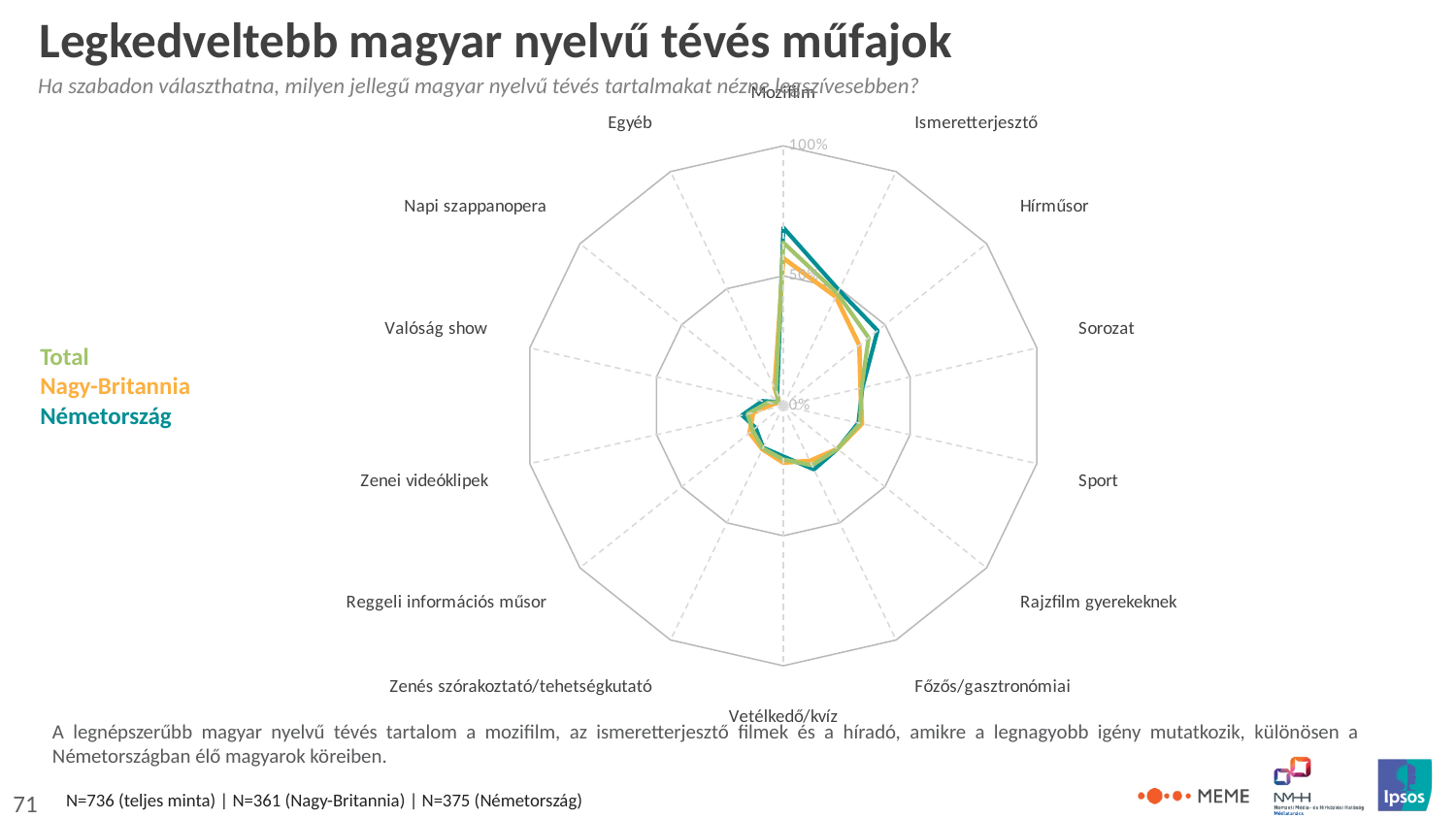
Which series are shown in the legend of the chart? Total, Nagy-Britannia, Németország What is the highest percentage tick shown on the radar chart's axis? 100% Which is larger for the Total series: Mozifilm or Sport? Mozifilm Which is larger for the Németország series: Hírműsor or Zenei videóklipek? Hírműsor How many categories (TV genres) are plotted on the radar chart? 14 Is the value for Napi szappanopera in the Total series greater or less than 50%? less Is the value for Valóság show in the Nagy-Britannia series greater or less than 50%? less What kind of chart is shown on the slide? Radar chart Which category has the highest values on the radar chart? Mozifilm Is the value for Mozifilm in the Németország series greater or less than 50%? greater How many series does the legend list? 3